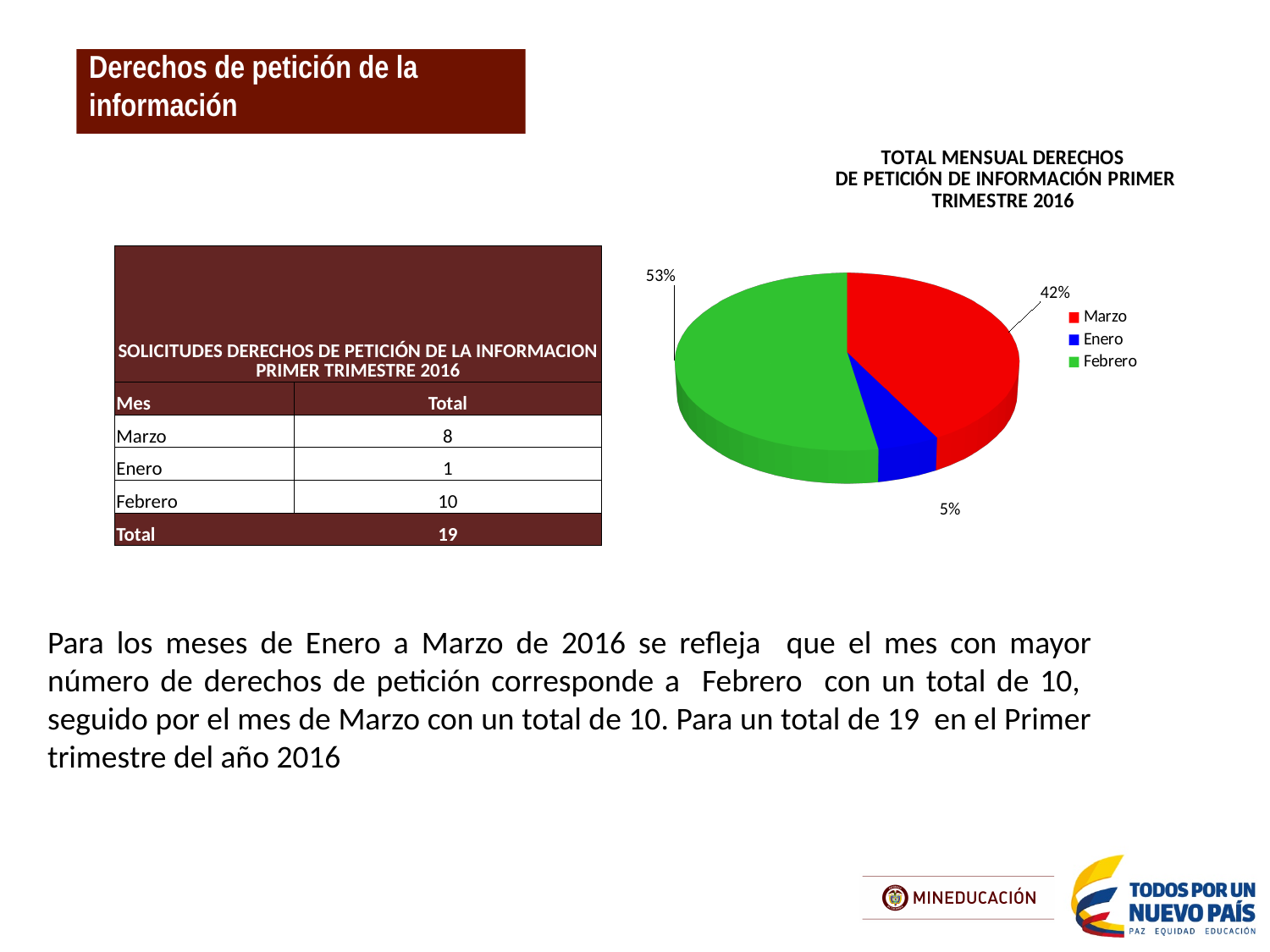
What is the title of the pie chart? TOTAL MENSUAL DERECHOS DE PETICIÓN DE INFORMACIÓN PRIMER TRIMESTRE 2016 How many slices does the pie chart have? 3 Which month has the smallest slice of the pie? Enero How many percentage points larger is the Febrero slice than the Marzo slice? 11 How many entries does the chart legend list? 3 What percentage of the pie does the Febrero slice represent? 53% What kind of chart is shown on the slide? pie chart What percentage of the pie does the Marzo slice represent? 42% Which month has the largest slice of the pie? Febrero What colour is the Marzo slice in the pie chart? red Which slice is larger, Marzo or Enero? Marzo What percentage of the pie does the Enero slice represent? 5%